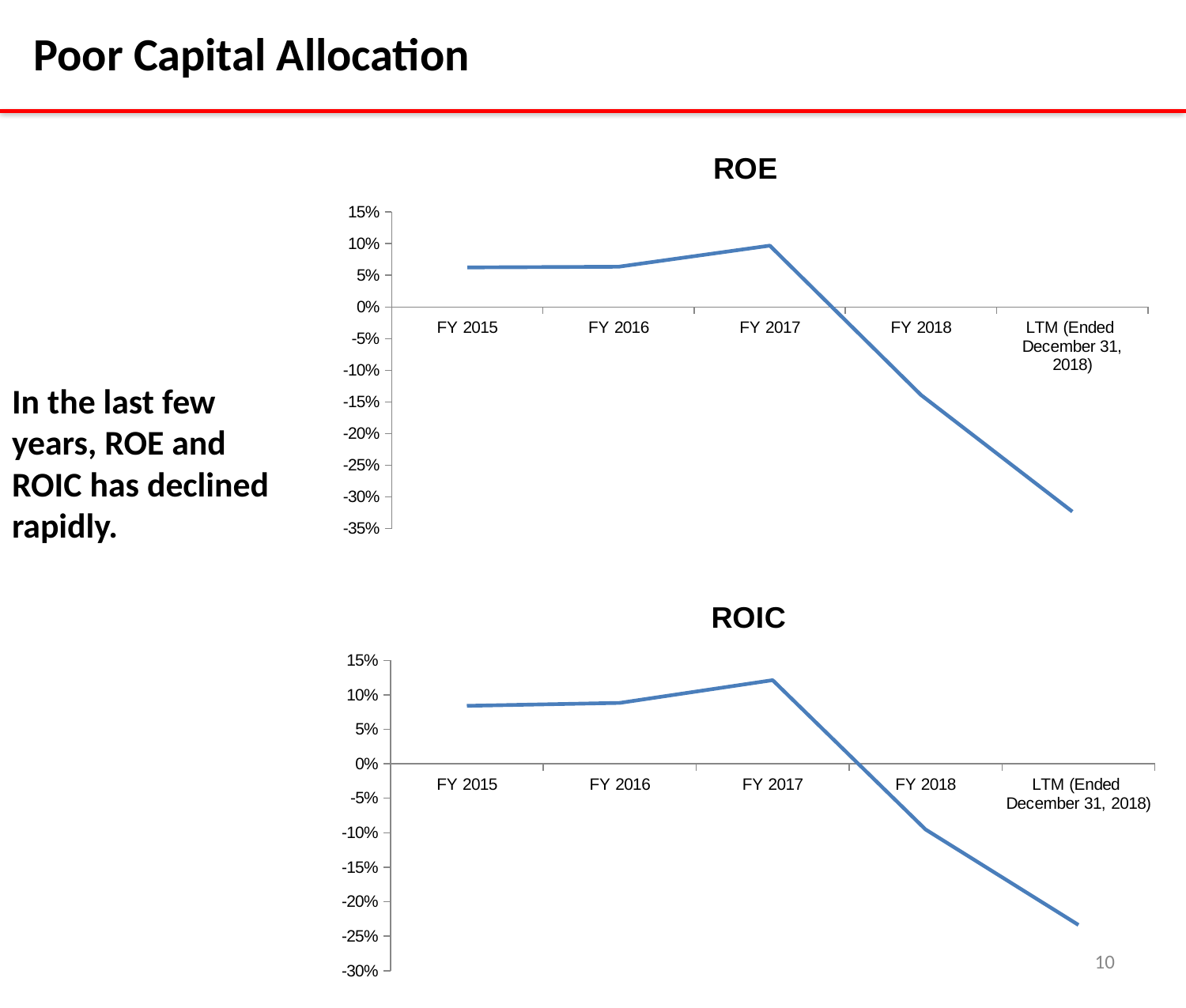
On the ROE chart, which is larger, the value for FY 2017 or the value for FY 2018? FY 2017 On the ROE chart, what kind of chart is shown? Line chart On the ROE chart, is the value for FY 2018 greater or less than -10%? less On the ROIC chart, which period has the highest ROIC? FY 2017 On the ROE chart, is the value for FY 2017 greater or less than 5%? greater On the ROIC chart, do the values rise or fall from FY 2017 to LTM (Ended December 31, 2018)? fall On the ROIC chart, is the value for FY 2015 greater or less than 5%? greater On the ROIC chart, which period has the lowest ROIC? LTM (Ended December 31, 2018) On the ROE chart, which period has the lowest ROE? LTM (Ended December 31, 2018) On the ROE chart, how many periods are plotted along the x axis? 5 On the ROE chart, which period has the highest ROE? FY 2017